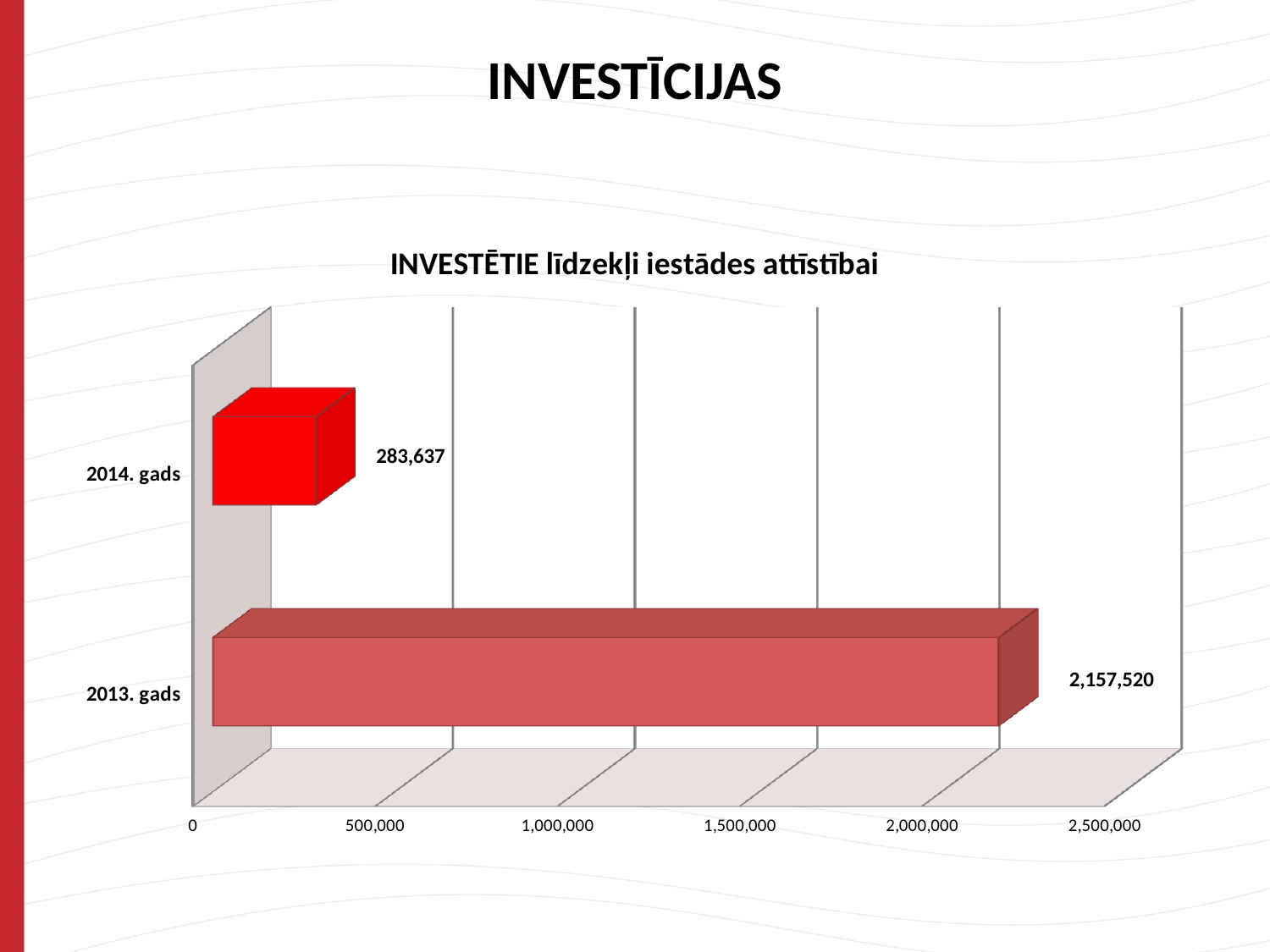
Which year has the lowest value? 2014. gads What is the highest value shown on the horizontal axis? 2,500,000 Which is larger, the value for 2013. gads or the value for 2014. gads? 2013. gads How many categories are shown in the chart? 2 What is the title of the chart? INVESTĒTIE līdzekļi iestādes attīstībai What is the difference between the values for 2013. gads and 2014. gads? 1,873,883 Is the value for 2013. gads greater or less than 2,000,000? greater What is the value for 2013. gads? 2,157,520 What kind of chart is shown on the slide? bar chart What is the value for 2014. gads? 283,637 Which year has the highest value? 2013. gads Is the value for 2014. gads greater or less than 500,000? less